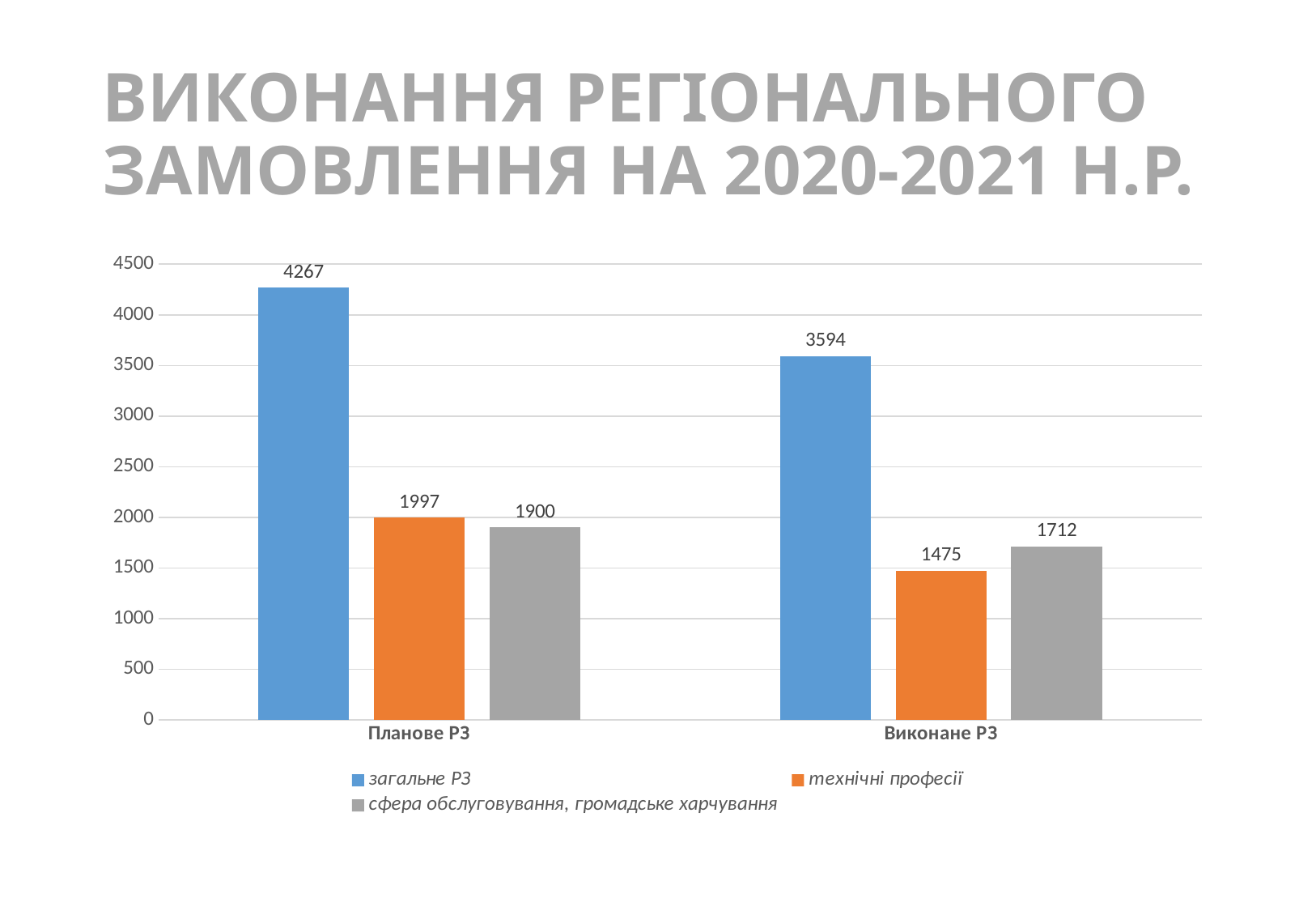
What kind of chart is shown on the slide? bar chart What is the value of технічні професії for Виконане РЗ? 1475 What is the difference between технічні професії for Планове РЗ and for Виконане РЗ? 522 What is the value of загальне РЗ for Планове РЗ? 4267 What is the difference between загальне РЗ for Планове РЗ and for Виконане РЗ? 673 Which series has the highest value for Виконане РЗ? загальне РЗ How many series does the legend list? 3 How many categories are shown on the x axis? 2 Which is larger: технічні професії for Виконане РЗ or сфера обслуговування, громадське харчування for Виконане РЗ? сфера обслуговування, громадське харчування What is the value of сфера обслуговування, громадське харчування for Планове РЗ? 1900 What is the value of загальне РЗ for Виконане РЗ? 3594 Which series has the lowest value for Виконане РЗ? технічні професії